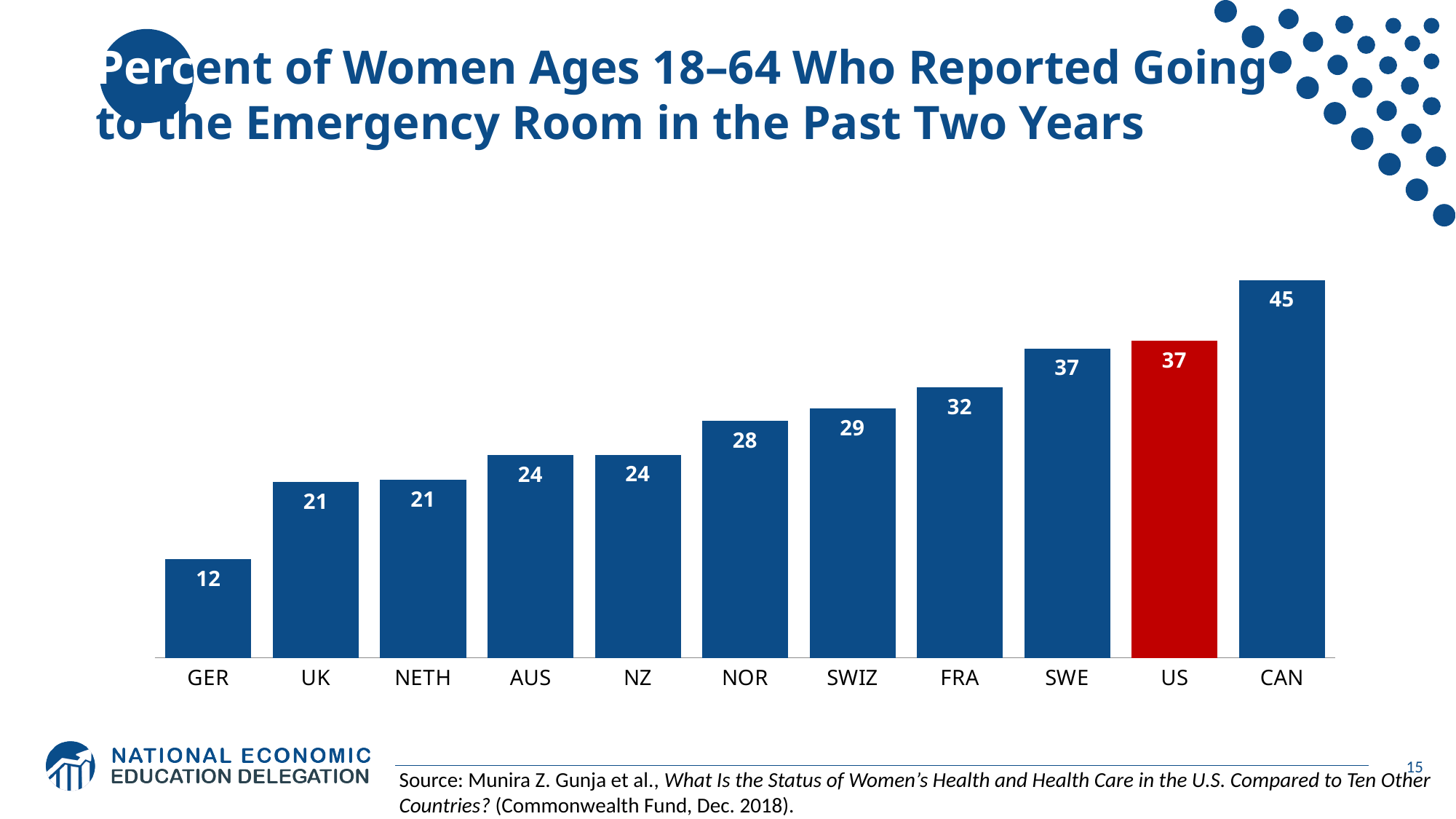
Which country has the highest value? CAN What kind of chart is shown on the slide? Bar chart What is the difference between the values for CAN and the US? 8 What is the difference between the values for FRA and UK? 11 What is the value for the US? 37 How many countries are shown in the chart? 11 Which country has the lowest value? GER Which country's bar is coloured red? US What is the value for NOR? 28 Do the values rise or fall from left to right along the x axis? Rise What is the value for GER? 12 Which is larger, the value for SWIZ or the value for AUS? SWIZ